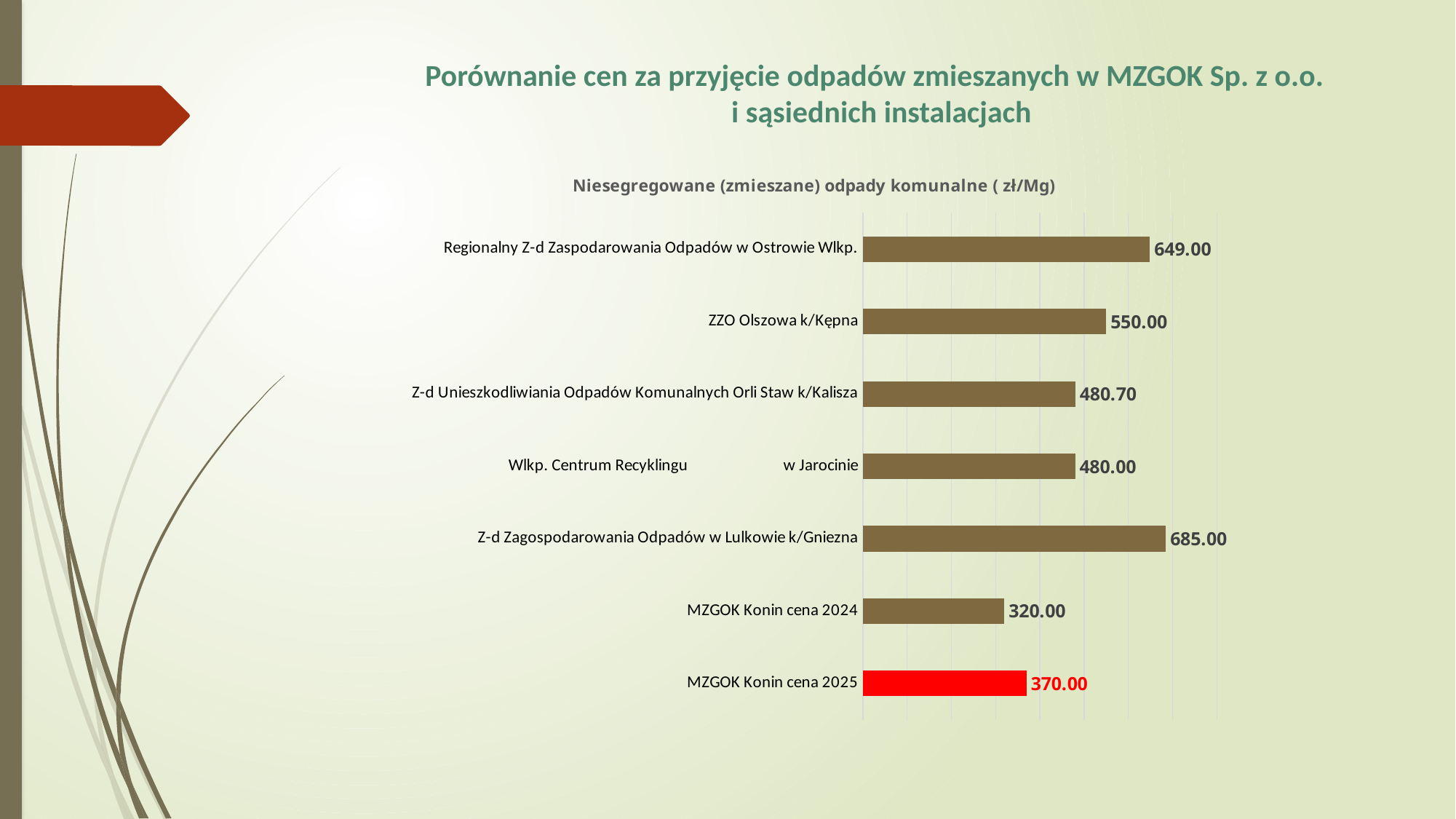
What is the value for Z-d Unieszkodliwiania Odpadów Komunalnych Orli Staw k/Kalisza? 480.70 What is the value for MZGOK Konin cena 2025? 370.00 Which is larger, the value for ZZO Olszowa k/Kępna or the value for Wlkp. Centrum Recyklingu w Jarocinie? ZZO Olszowa k/Kępna Which category has the highest value? Z-d Zagospodarowania Odpadów w Lulkowie k/Gniezna What is the value for MZGOK Konin cena 2024? 320.00 What is the value for Regionalny Z-d Zaspodarowania Odpadów w Ostrowie Wlkp.? 649.00 What is the difference between the MZGOK Konin cena 2025 value and the MZGOK Konin cena 2024 value? 50.00 Which category has the lowest value? MZGOK Konin cena 2024 What is the difference between the value for Z-d Zagospodarowania Odpadów w Lulkowie k/Gniezna and the value for Regionalny Z-d Zaspodarowania Odpadów w Ostrowie Wlkp.? 36.00 Which category's bar is coloured red? MZGOK Konin cena 2025 What is the value for ZZO Olszowa k/Kępna? 550.00 How many categories are shown in the chart? 7